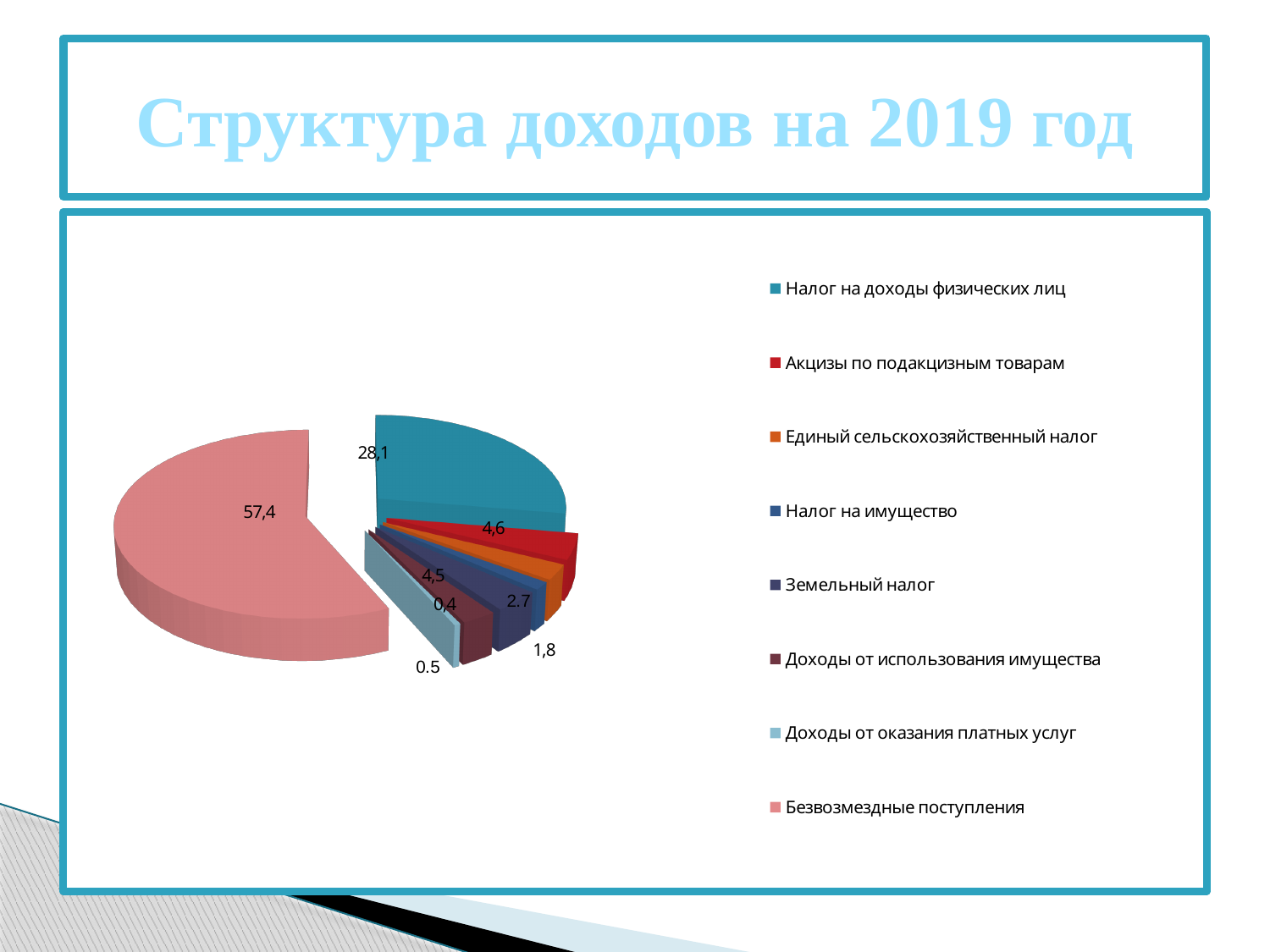
Which is larger: Налог на доходы физических лиц or Акцизы по подакцизным товарам? Налог на доходы физических лиц What colour is the largest slice of the pie? pink What is the title of the slide? Структура доходов на 2019 год What is the value shown for Налог на доходы физических лиц? 28,1 What kind of chart is shown on the slide? pie chart What share of the pie does Безвозмездные поступления take? 57,4 What is the difference between the values for Безвозмездные поступления and Налог на доходы физических лиц? 29,3 What is the value shown for Акцизы по подакцизным товарам? 4,6 Which category has the largest slice of the pie? Безвозмездные поступления What is the value shown for Земельный налог? 4,5 What is the value shown for Безвозмездные поступления? 57,4 How many categories does the legend of the pie chart list? 8